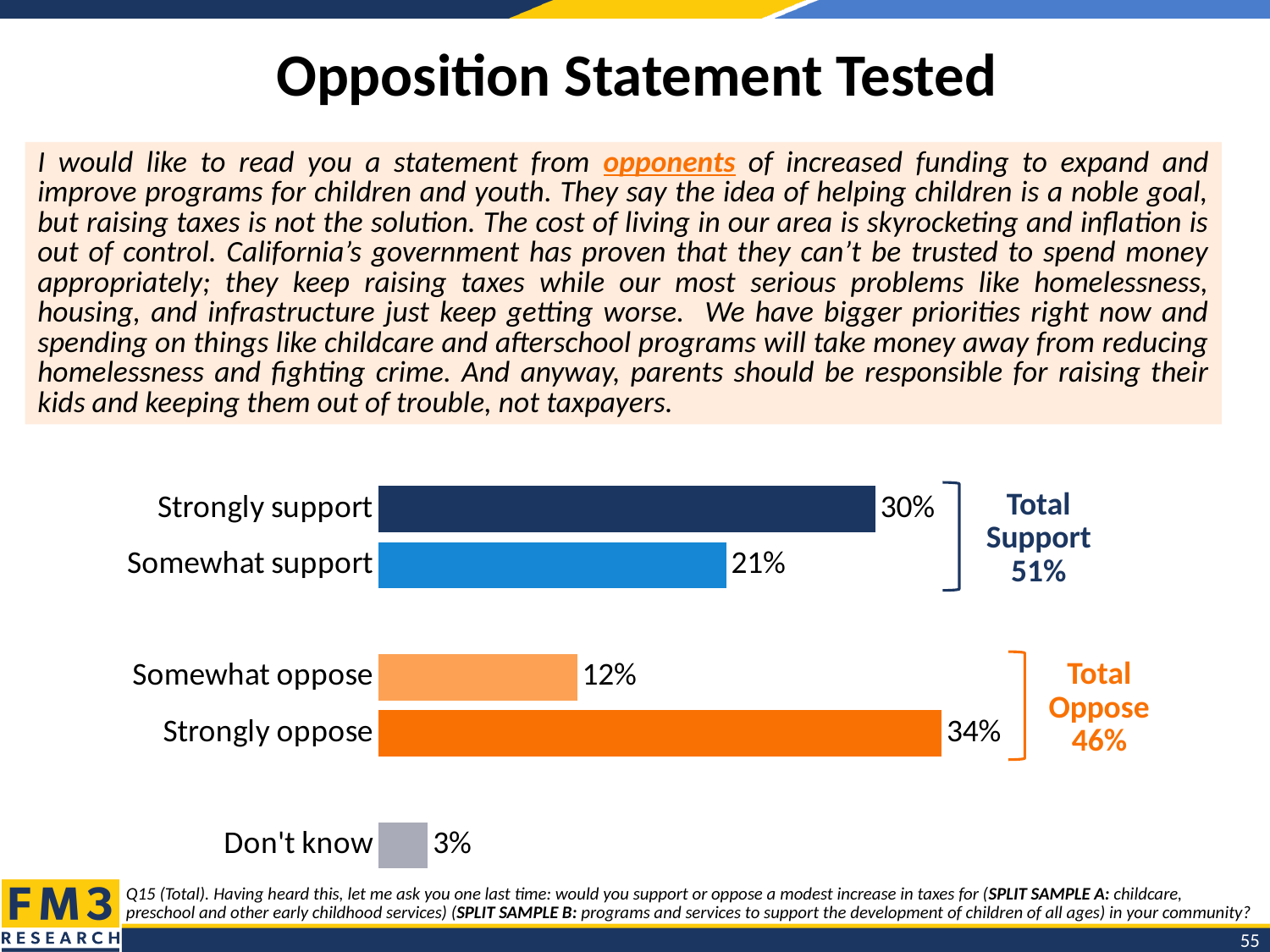
Which response category has the lowest percentage? Don't know What percentage of respondents said they somewhat oppose? 12% Which response category has the highest percentage? Strongly oppose What percentage of respondents answered Don't know? 3% How many response categories are shown in the chart? 5 What is the Total Oppose percentage shown on the slide? 46% Which is larger, Somewhat support or Somewhat oppose? Somewhat support What is the difference between the Strongly oppose and Strongly support percentages? 4% What type of chart is shown on the slide? Bar chart What is the Total Support percentage shown on the slide? 51% What is the title of the slide? Opposition Statement Tested What percentage of respondents said they strongly support? 30%